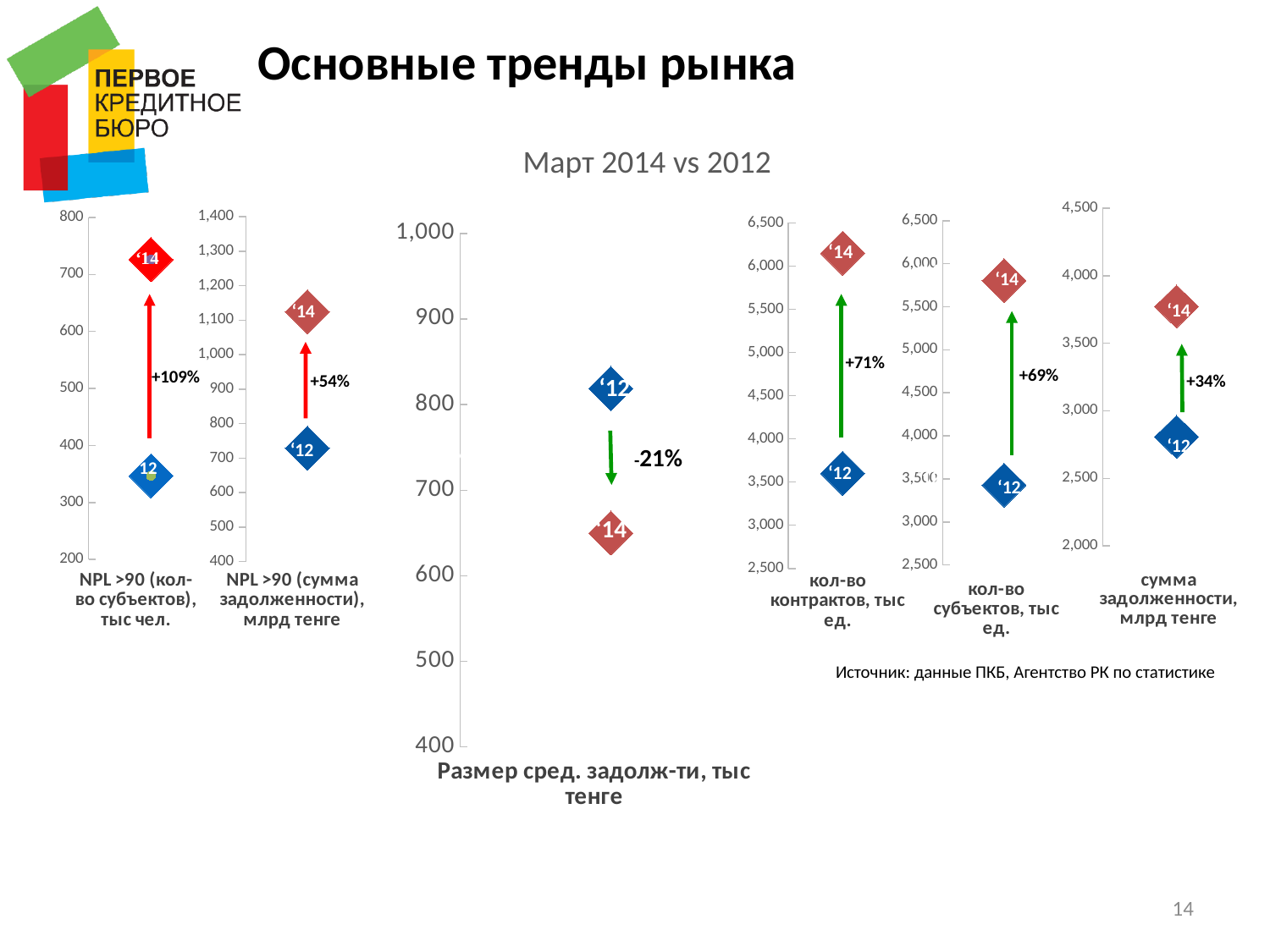
In the chart titled "кол-во контрактов, тыс ед.", what percentage change is printed next to the arrow? +71% In the chart titled "NPL >90 (сумма задолженности), млрд тенге", does the value rise or fall from '12 to '14? rise In the chart titled "Размер сред. задолж-ти, тыс тенге", which point is higher, '12 or '14? '12 In the chart titled "Размер сред. задолж-ти, тыс тенге", what percentage change is shown between '12 and '14? -21% In the chart titled "сумма задолженности, млрд тенге", what percentage change is shown? +34% In the chart titled "кол-во субъектов, тыс ед.", what percentage change is shown? +69% In the chart titled "кол-во контрактов, тыс ед.", is the value for '12 greater or less than 4,000? less In the chart titled "сумма задолженности, млрд тенге", is the value for '14 greater or less than 3,500? greater In the chart titled "NPL >90 (сумма задолженности), млрд тенге", what percentage change is printed next to the arrow? +54% In the chart titled "NPL >90 (кол-во субъектов), тыс чел.", what percentage change is shown between '12 and '14? +109% How many data points are plotted in the chart titled "кол-во субъектов, тыс ед."? 2 In the chart titled "NPL >90 (кол-во субъектов), тыс чел.", is the value for '14 greater or less than 700? greater